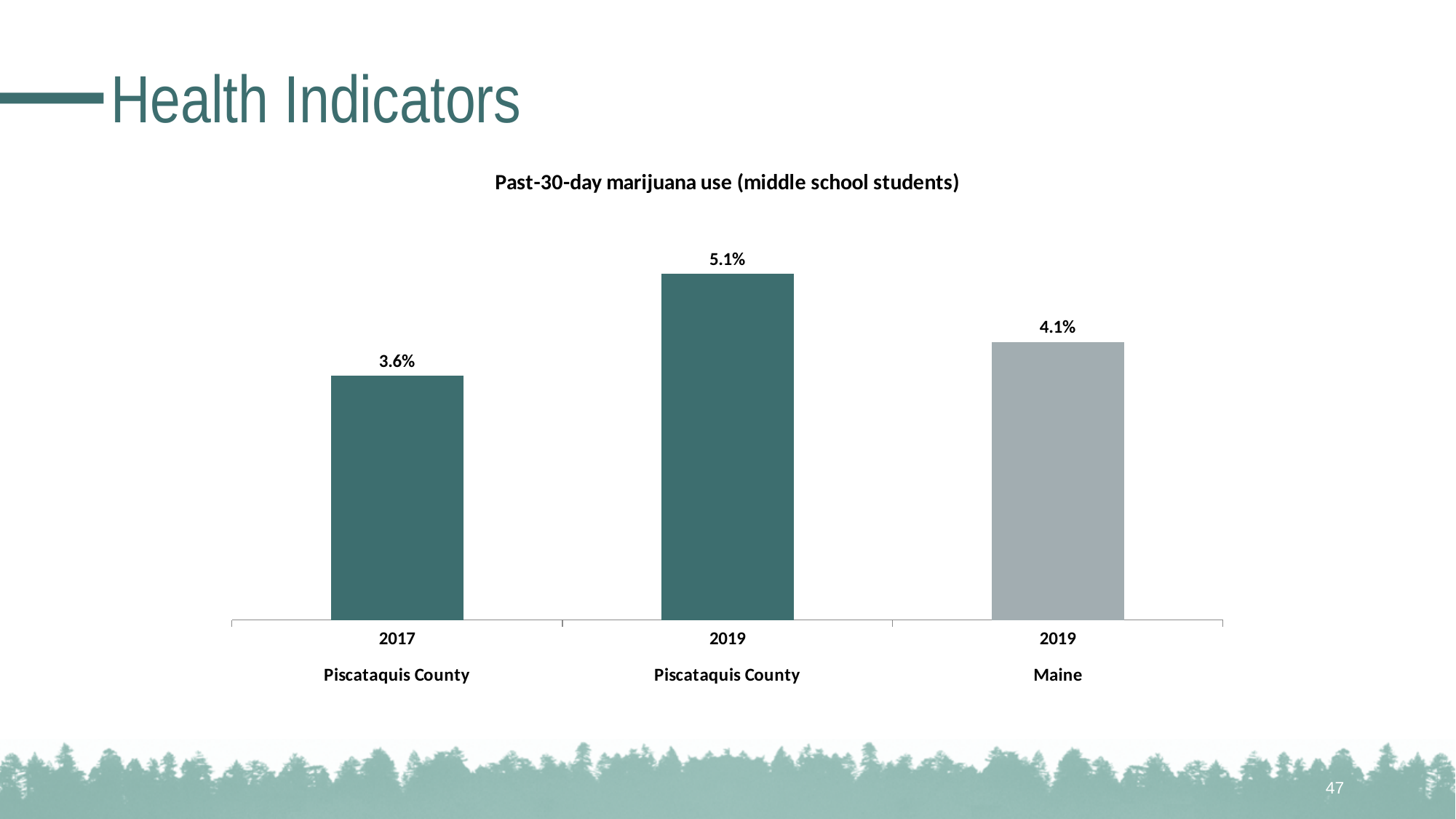
How many bars are shown in the chart? 3 In 2019, which had a higher past-30-day marijuana use rate among middle school students: Piscataquis County or Maine? Piscataquis County Which bar shows the lowest past-30-day marijuana use rate? 2017 Piscataquis County By how many percentage points did past-30-day marijuana use in Piscataquis County change from 2017 to 2019? 1.5 percentage points What type of chart is shown on the slide? Bar chart What is the past-30-day marijuana use rate for Maine middle school students in 2019? 4.1% Did past-30-day marijuana use among Piscataquis County middle school students rise or fall from 2017 to 2019? Rise What is the difference between the 2019 Piscataquis County rate and the 2019 Maine rate? 1.0 percentage point What is the title of the chart? Past-30-day marijuana use (middle school students) What is the past-30-day marijuana use rate for Piscataquis County middle school students in 2017? 3.6% What is the past-30-day marijuana use rate for Piscataquis County middle school students in 2019? 5.1% Which bar shows the highest past-30-day marijuana use rate? 2019 Piscataquis County